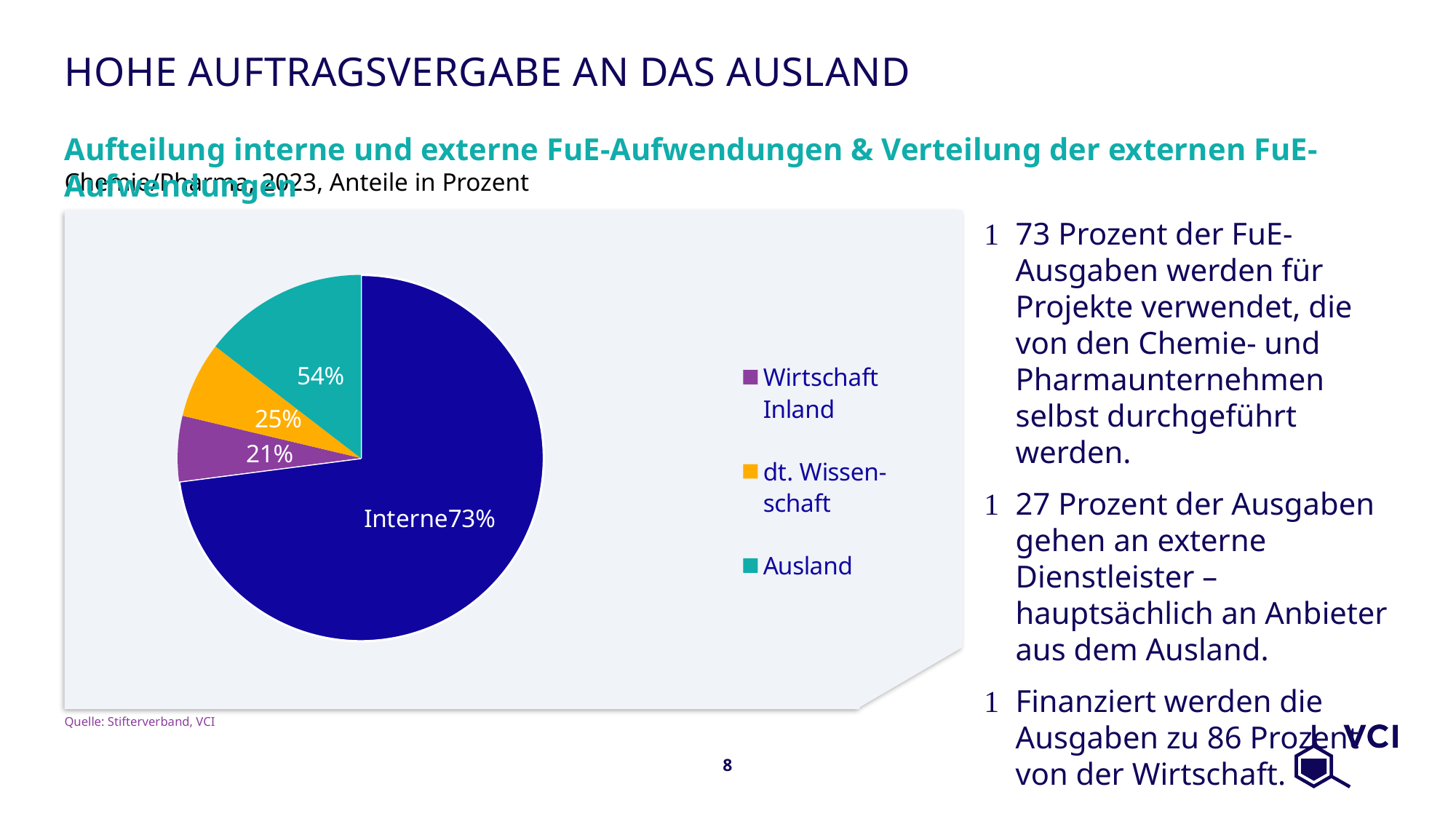
What is the difference between the printed percentages for Ausland and dt. Wissenschaft? 29 percentage points What colour is the Ausland slice in the pie chart? Teal What percentage is shown for the Ausland slice? 54% What percentage is shown for the Wirtschaft Inland slice? 21% How many slices does the pie chart have? 4 What percentage is shown for the dt. Wissenschaft slice? 25% What percentage is shown for the Interne slice of the pie chart? 73% Which has the larger printed percentage, Ausland or dt. Wissenschaft? Ausland What kind of chart is shown on the slide? Pie chart How many entries does the legend of the pie chart list? 3 Which slice of the pie chart has the largest printed percentage? Interne Which slice of the pie chart has the smallest printed percentage? Wirtschaft Inland